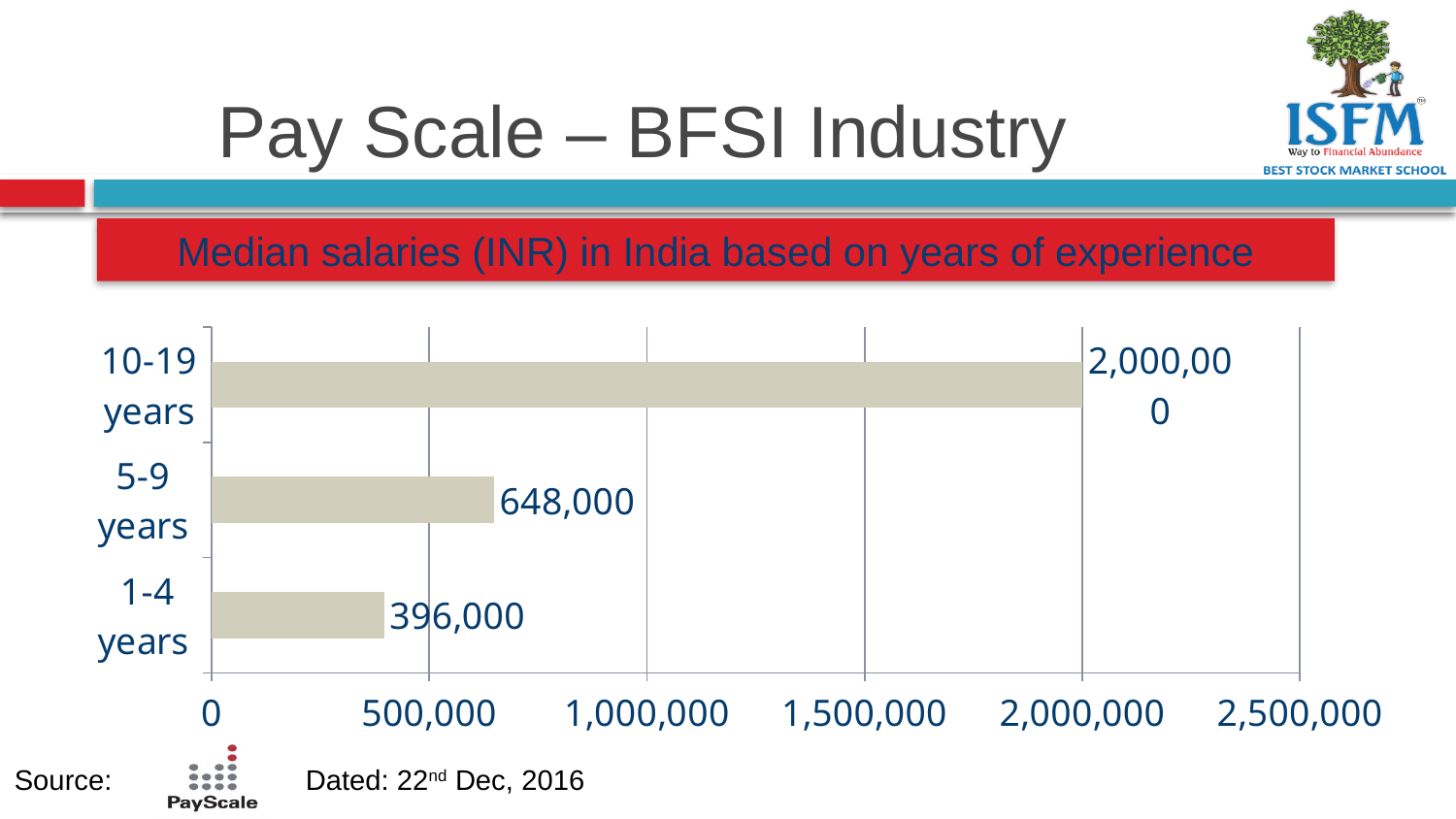
What is the title shown above the chart? Median salaries (INR) in India based on years of experience What type of chart is shown on the slide? Bar chart Which experience category has the lowest median salary? 1-4 years What is the median salary for 1-4 years of experience? 396,000 Which experience category has the highest median salary? 10-19 years Is the median salary for 5-9 years of experience greater or less than 500,000? greater What is the difference between the median salaries for 10-19 years and 5-9 years of experience? 1,352,000 What is the median salary for 10-19 years of experience? 2,000,000 What is the median salary for 5-9 years of experience? 648,000 What is the difference between the median salaries for 5-9 years and 1-4 years of experience? 252,000 How many experience categories are shown in the chart? 3 Which is larger, the median salary for 5-9 years or for 1-4 years of experience? 5-9 years